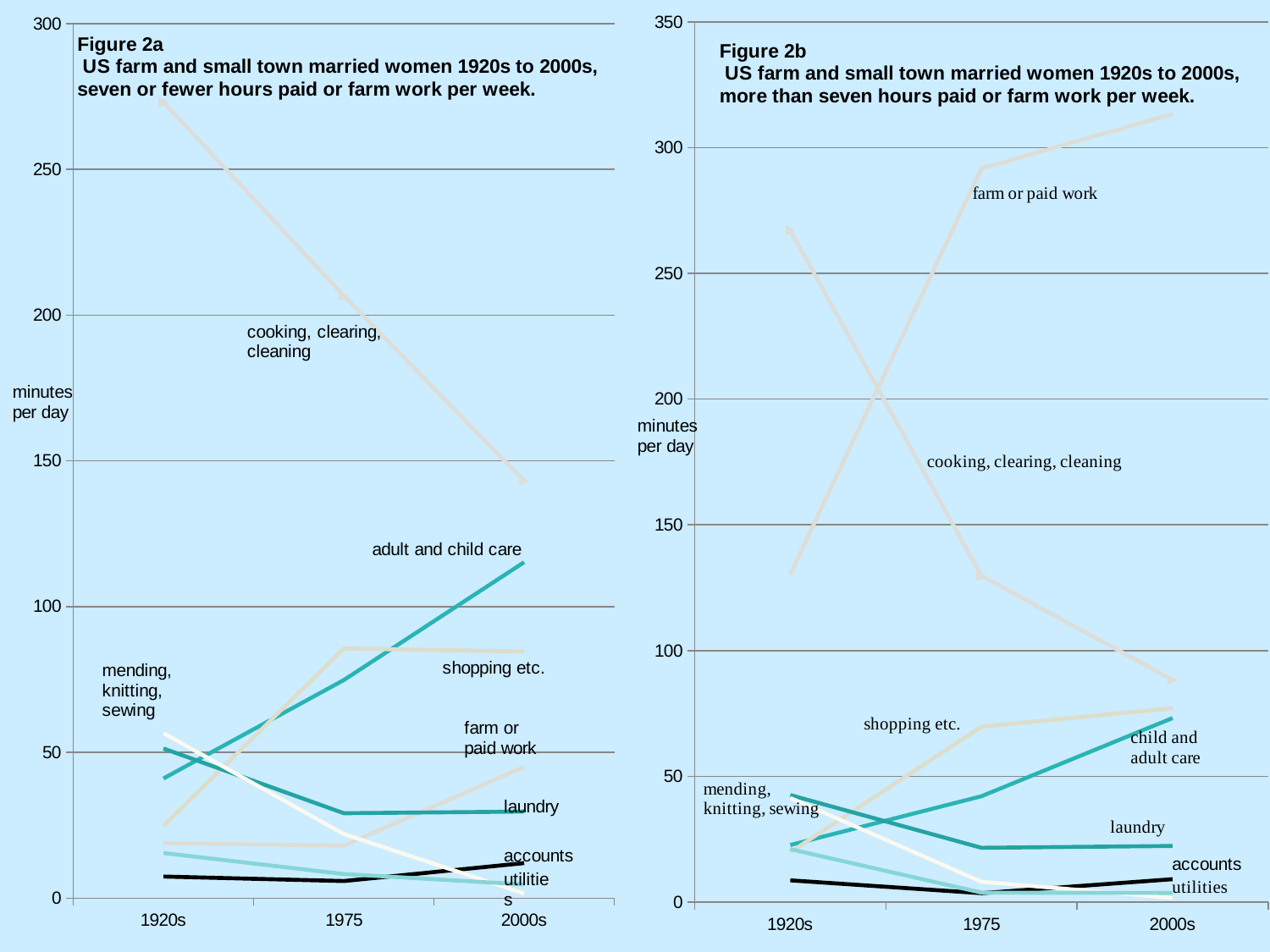
What kind of chart is Figure 2a? line chart In Figure 2b, which activity has the highest value in the 1920s? cooking, clearing, cleaning In Figure 2b, is the value for farm or paid work in the 2000s greater or less than 300? greater In Figure 2a, is the value for cooking, clearing, cleaning in the 1920s greater or less than 250? greater How many time points are shown on the x axis of Figure 2b? 3 In Figure 2a, does the line for adult and child care rise or fall from the 1920s to the 2000s? rise In Figure 2a, which is larger in the 2000s: adult and child care or shopping etc.? adult and child care In Figure 2a, is the value for cooking, clearing, cleaning in the 2000s greater or less than 150? less What is the label on the y axis of Figure 2b? minutes per day In Figure 2b, does the line for farm or paid work rise or fall from the 1920s to the 2000s? rise In Figure 2a, which activity has the highest value in the 2000s? cooking, clearing, cleaning In Figure 2a, does the line for cooking, clearing, cleaning rise or fall from the 1920s to the 2000s? fall